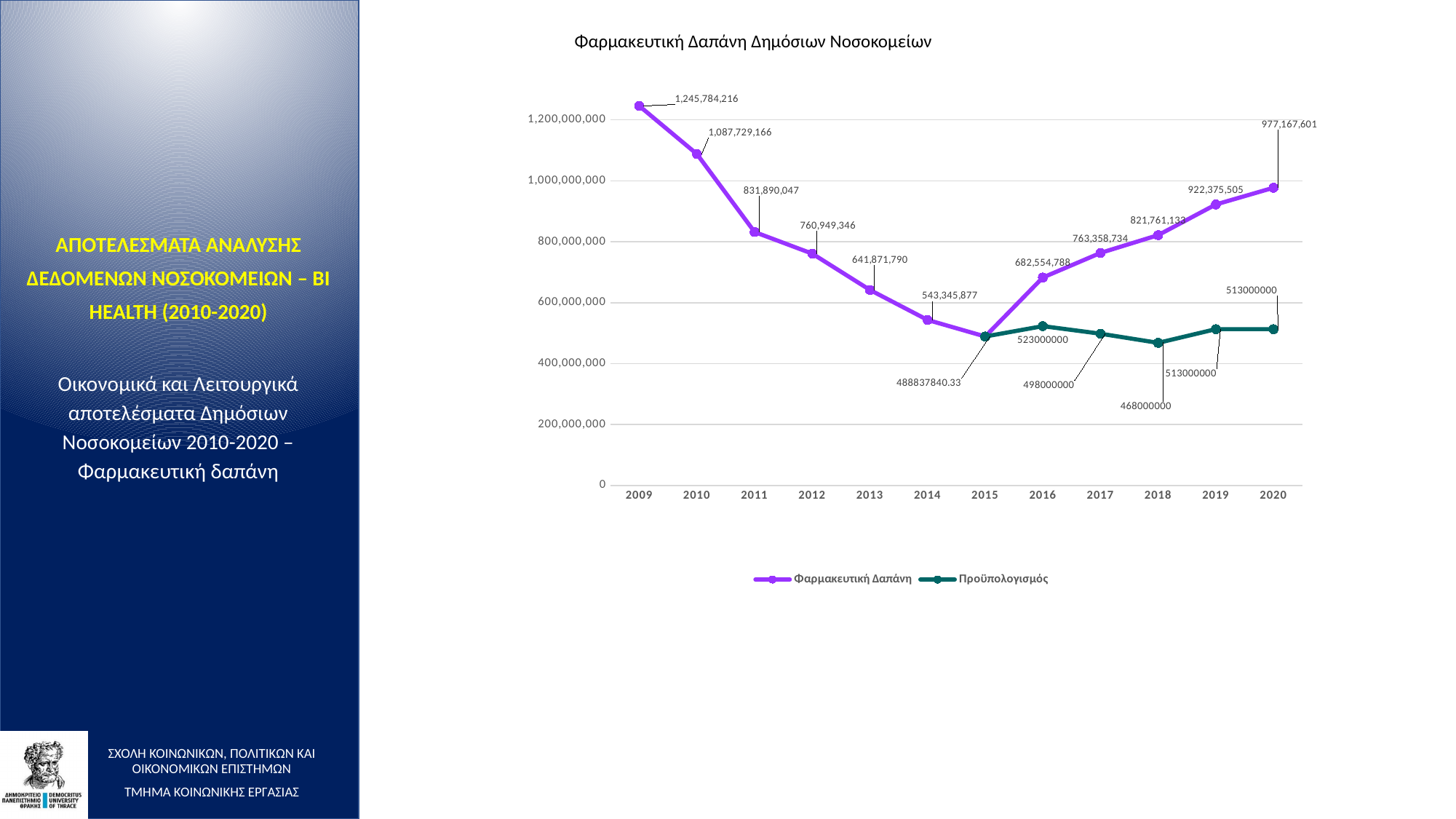
What kind of chart is shown on the slide? Line chart In 2016, which is larger: Φαρμακευτική Δαπάνη or Προϋπολογισμός? Φαρμακευτική Δαπάνη What is the difference between the Φαρμακευτική Δαπάνη values for 2020 and 2019? 54,792,096 What is the Προϋπολογισμός value for 2018? 468000000 In which year is the Φαρμακευτική Δαπάνη highest? 2009 How many series does the legend list? 2 In which year is the Προϋπολογισμός lowest? 2018 Does the Φαρμακευτική Δαπάνη rise or fall from 2009 to 2014? Fall Is the Φαρμακευτική Δαπάνη value for 2015 greater or less than 600,000,000? less What is the Φαρμακευτική Δαπάνη value for 2009? 1,245,784,216 How many years are shown on the x axis? 12 What is the Φαρμακευτική Δαπάνη value for 2020? 977,167,601